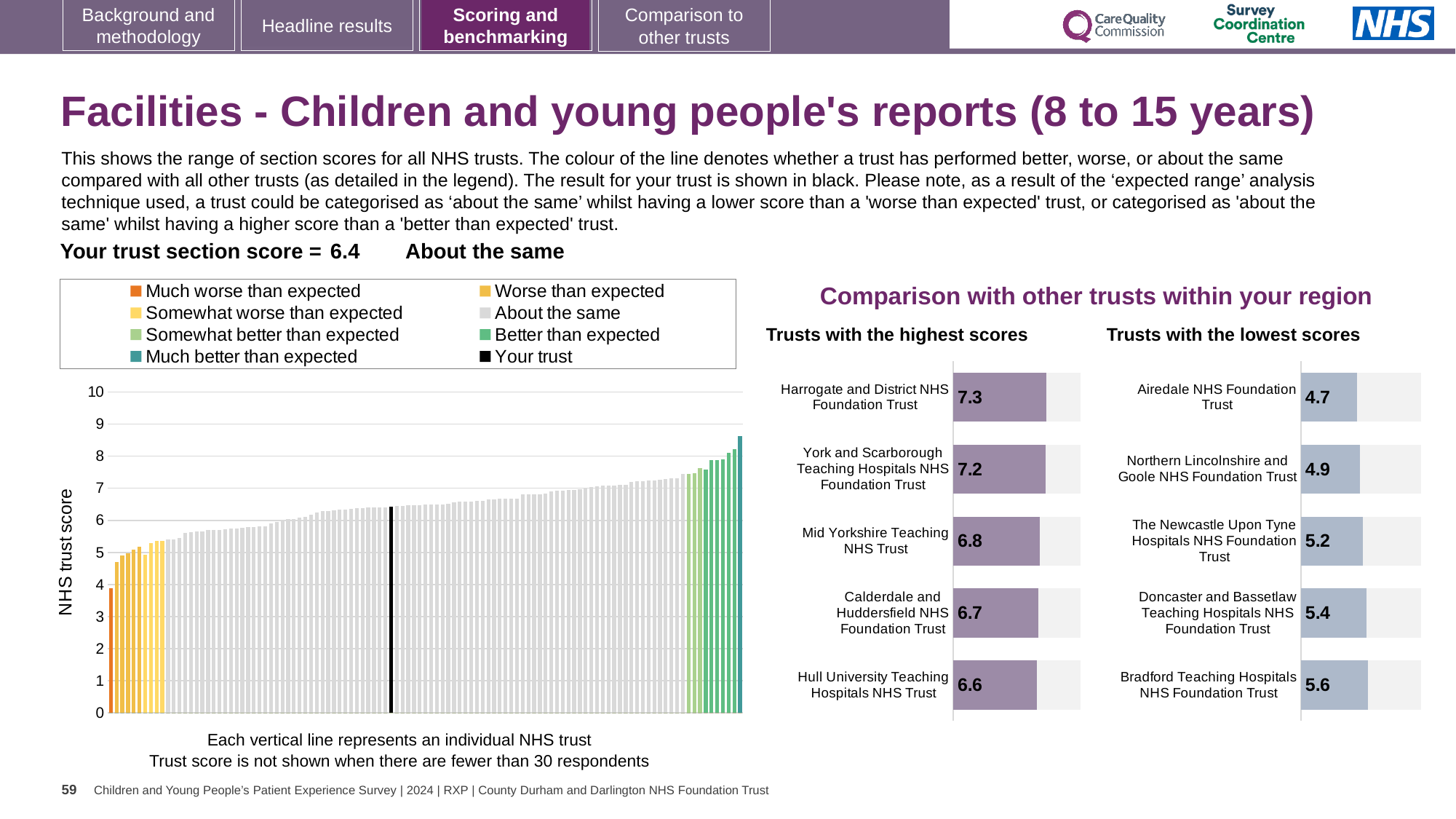
In the 'Trusts with the highest scores' chart, which trust has the highest score? Harrogate and District NHS Foundation Trust In the 'Trusts with the lowest scores' chart, what is the difference between the scores of Bradford Teaching Hospitals NHS Foundation Trust and Airedale NHS Foundation Trust? 0.9 Which has the higher score: Mid Yorkshire Teaching NHS Trust in the highest scores chart or The Newcastle Upon Tyne Hospitals NHS Foundation Trust in the lowest scores chart? Mid Yorkshire Teaching NHS Trust In the 'Trusts with the lowest scores' chart, what is the score for Doncaster and Bassetlaw Teaching Hospitals NHS Foundation Trust? 5.4 In the 'Trusts with the highest scores' chart, what is the difference between the scores of Harrogate and District NHS Foundation Trust and Hull University Teaching Hospitals NHS Trust? 0.7 In the 'Trusts with the highest scores' chart, what is the score for Harrogate and District NHS Foundation Trust? 7.3 In the 'Trusts with the lowest scores' chart, what is the score for Airedale NHS Foundation Trust? 4.7 In the large chart on the left, do the NHS trust scores rise or fall from left to right? Rise What kind of chart is the large chart on the left showing NHS trust scores? Bar chart How many entries does the legend above the large chart on the left list? 8 How many trusts are listed in the 'Trusts with the highest scores' chart? 5 In the 'Trusts with the lowest scores' chart, which trust has the lowest score? Airedale NHS Foundation Trust